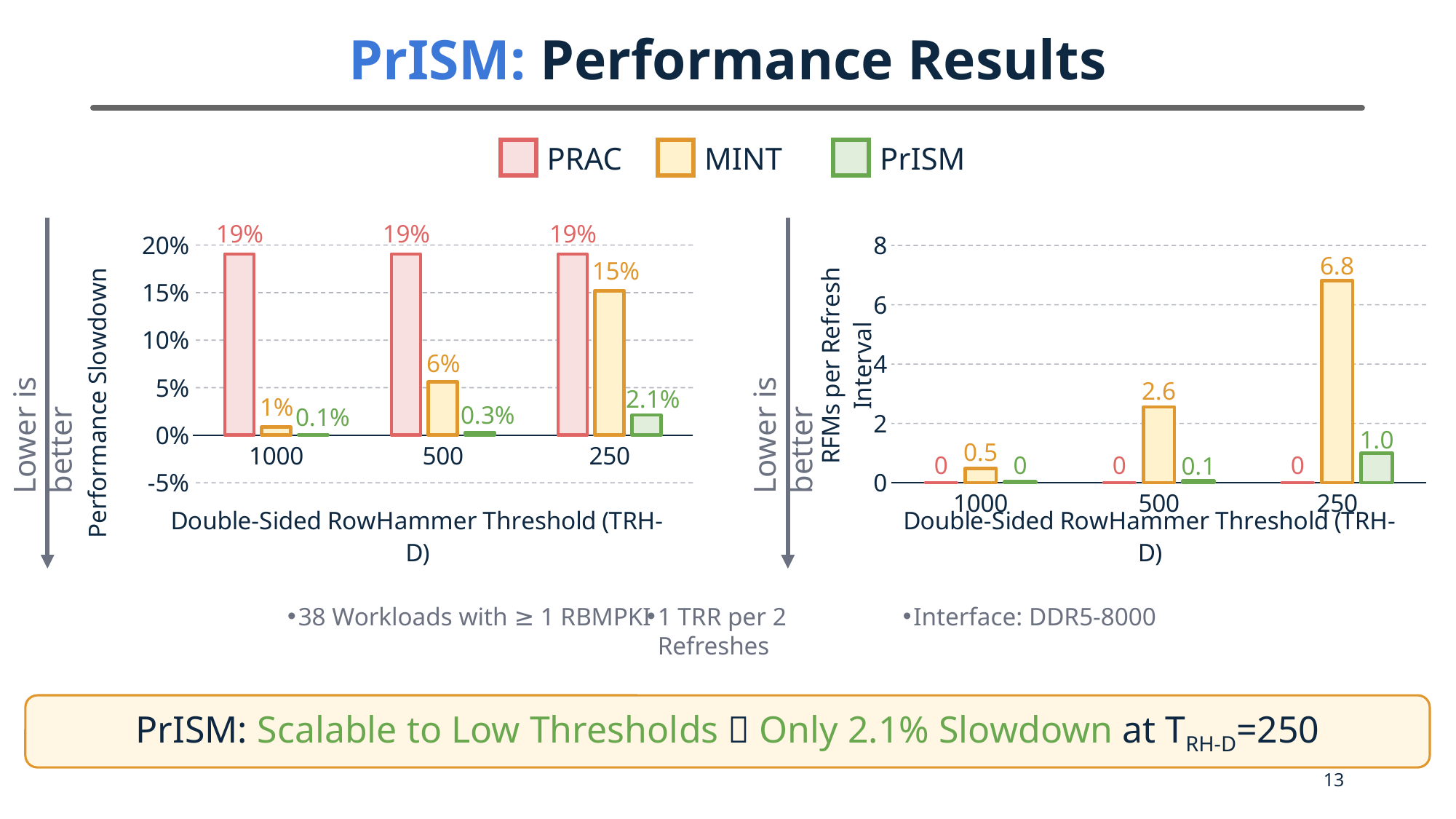
In the left chart (Performance Slowdown), what is the slowdown for PRAC at threshold 1000? 19% What kind of chart is the right chart (RFMs per Refresh Interval)? bar chart In the right chart (RFMs per Refresh Interval), which threshold has the highest value for MINT? 250 In the left chart (Performance Slowdown), which series has the highest slowdown at threshold 250? PRAC In the left chart (Performance Slowdown), does the MINT slowdown rise or fall as the threshold goes from 1000 to 250? rise In the left chart (Performance Slowdown), what is the difference between the PRAC and MINT slowdowns at threshold 250? 4% In the right chart (RFMs per Refresh Interval), what is the value for PrISM at threshold 500? 0.1 In the right chart (RFMs per Refresh Interval), what is the value for MINT at threshold 250? 6.8 In the left chart (Performance Slowdown), what is the slowdown for MINT at threshold 500? 6% In the left chart (Performance Slowdown), what is the slowdown for PrISM at threshold 250? 2.1% How many series does the legend list? 3 In the right chart (RFMs per Refresh Interval), what is the difference between the MINT values at thresholds 250 and 500? 4.2